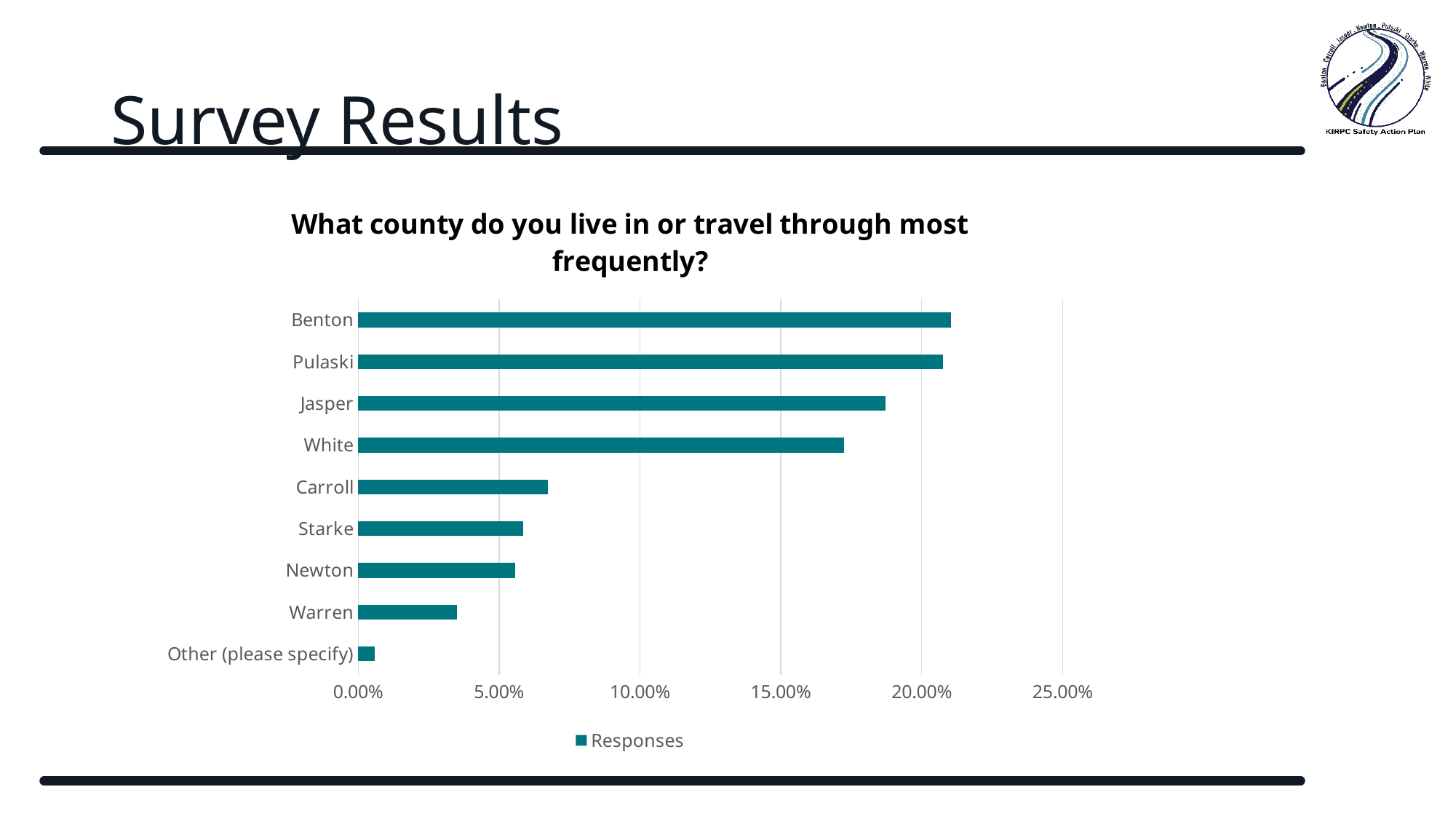
What kind of chart is shown on the slide? bar chart Which is larger, the value for Newton or the value for Warren? Newton Which category has the lowest value? Other (please specify) What is the title of the chart? What county do you live in or travel through most frequently? Is the value for Carroll greater or less than 10.00%? less Which is larger, the value for Jasper or the value for White? Jasper Is the value for Warren greater or less than 5.00%? less How many counties/categories are listed on the chart? 9 Is the value for Jasper greater or less than 20.00%? less How many series does the legend list? 1